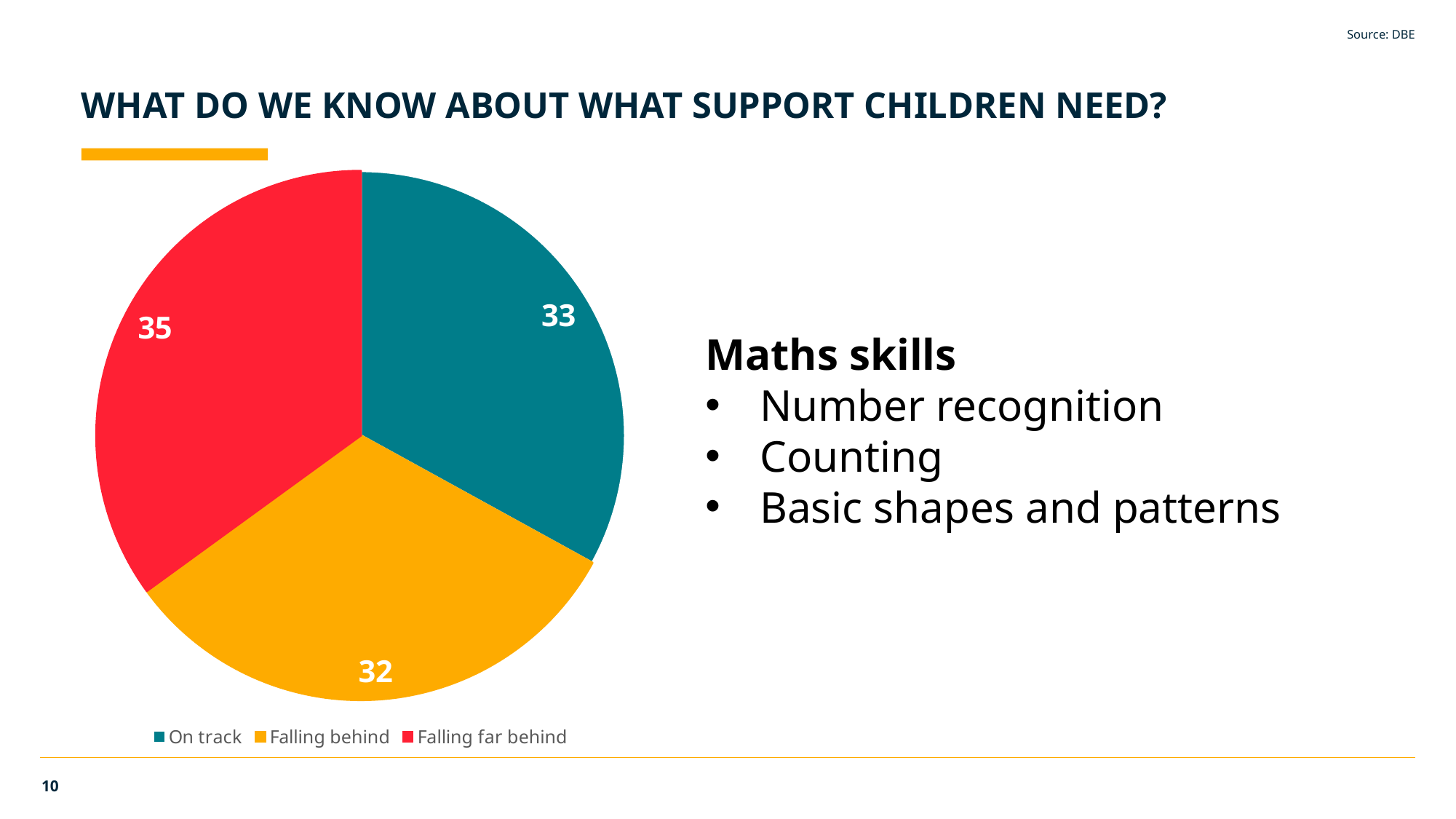
How many slices does the pie chart have? 3 Which is larger, the value for Falling far behind or the value for On track? Falling far behind What is the value for On track? 33 What is the difference between the values for On track and Falling behind? 1 Which category has the largest slice? Falling far behind What is the difference between the values for Falling far behind and Falling behind? 3 What is the value for Falling far behind? 35 What kind of chart is shown on the slide? Pie chart How many entries does the legend list? 3 Which category has the smallest slice? Falling behind What colour is the On track slice? Teal What is the value for Falling behind? 32